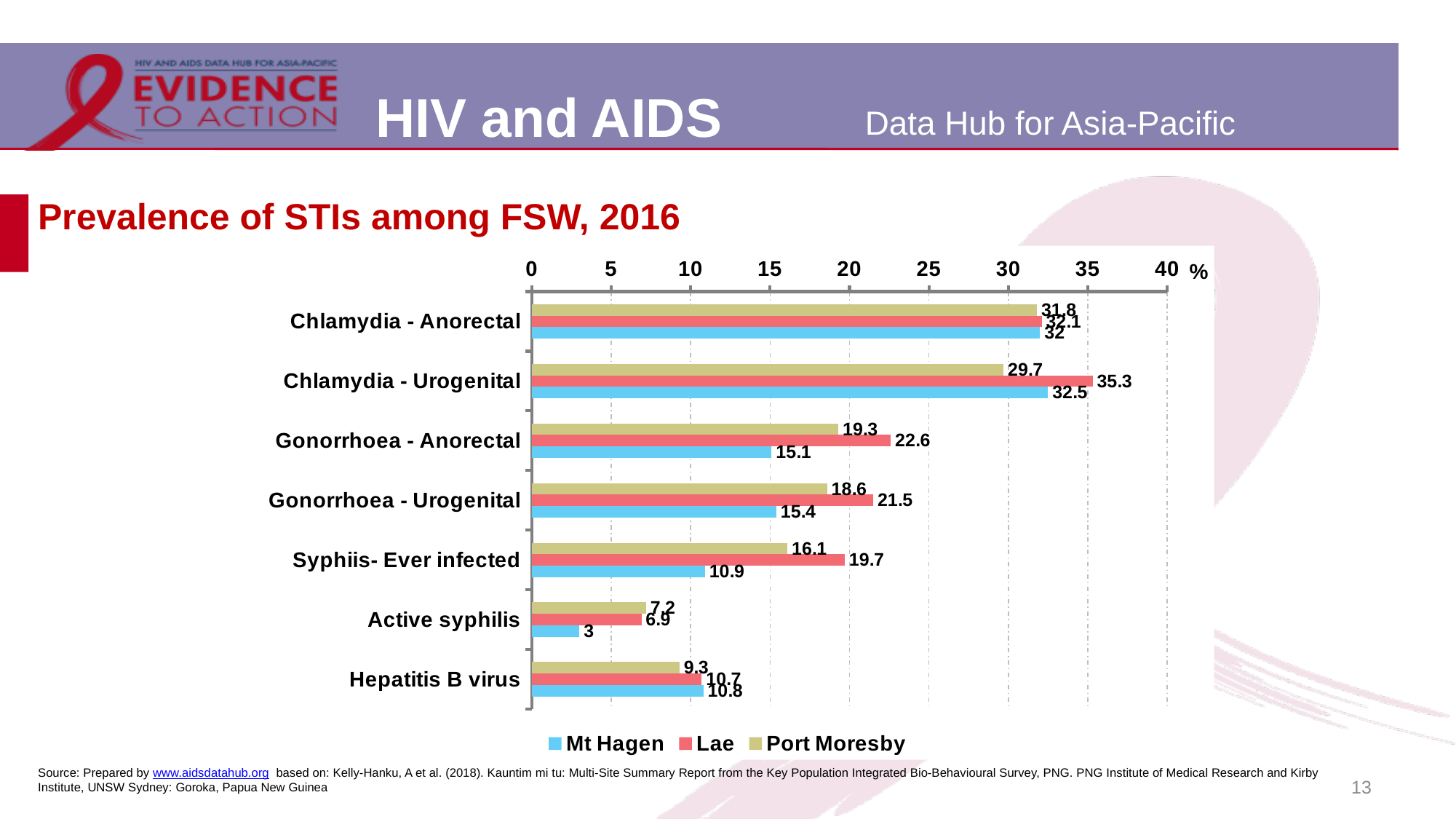
Is the value for Port Moresby for Chlamydia - Urogenital greater or less than 25? greater How many series does the legend list? 3 What is the value for Lae for Chlamydia - Urogenital? 35.3 What kind of chart is shown on the slide? Bar chart What is the value for Port Moresby for Gonorrhoea - Anorectal? 19.3 What is the value for Mt Hagen for Active syphilis? 3 How many STI categories are shown on the chart? 7 For Syphiis- Ever infected, which is larger: the value for Lae or for Port Moresby? Lae What is the difference between the Lae and Mt Hagen values for Gonorrhoea - Anorectal? 7.5 Which category has the highest value for Lae? Chlamydia - Urogenital Which category has the lowest value for Mt Hagen? Active syphilis What is the value for Mt Hagen for Syphiis- Ever infected? 10.9